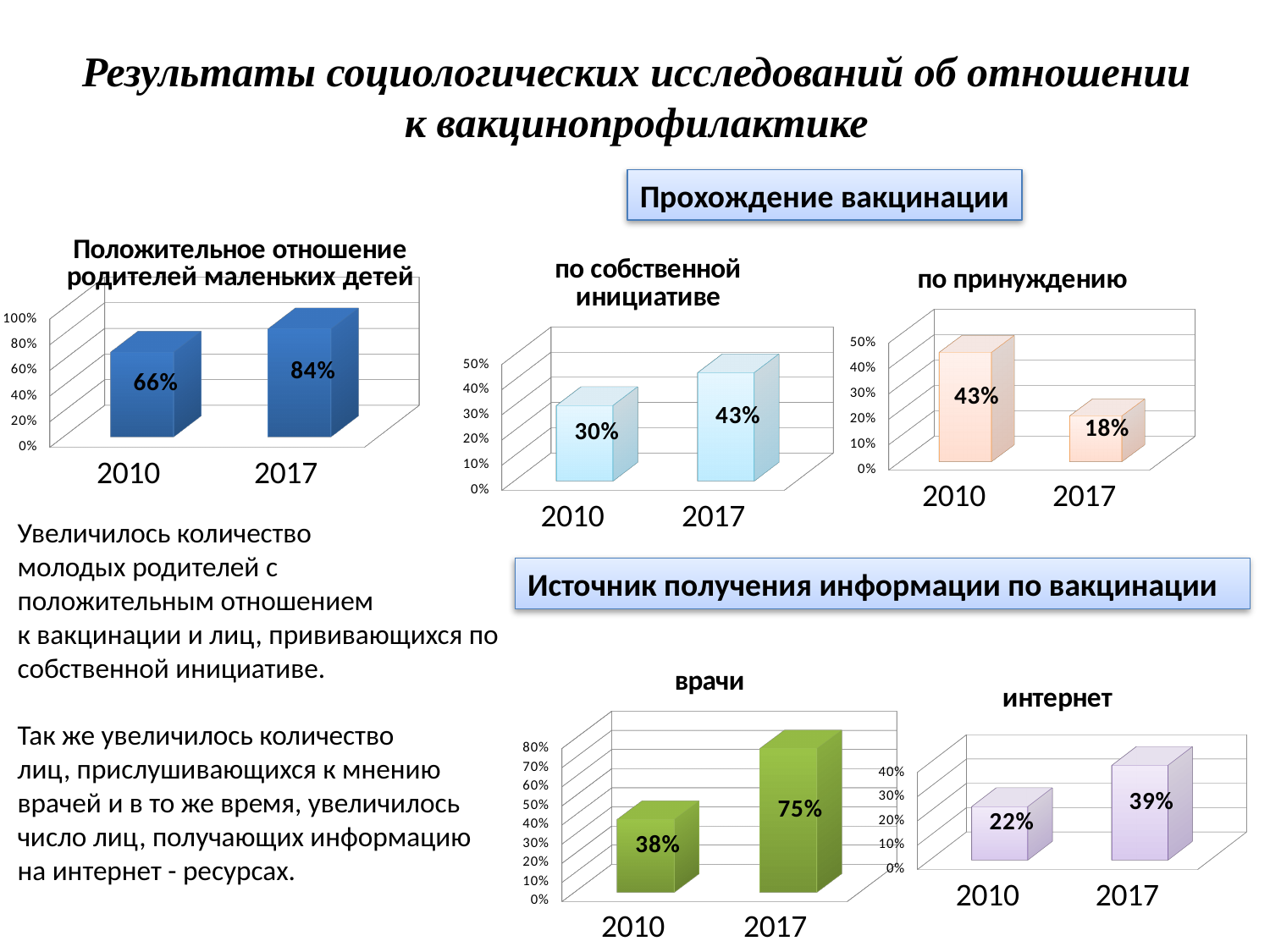
In the chart titled "по собственной инициативе", what is the value for 2010? 30% In the chart titled "по принуждению", do the values rise or fall from 2010 to 2017? fall In the chart titled "по принуждению", what is the difference between the 2010 and 2017 values? 25% In the chart titled "Положительное отношение родителей маленьких детей", what is the value for 2017? 84% In the chart titled "по собственной инициативе", which year has the higher value? 2017 In the chart titled "интернет", how many categories are shown on the x axis? 2 In the chart titled "по принуждению", what is the value for 2017? 18% What kind of chart is the one titled "врачи"? bar chart In the chart titled "врачи", which year has the lower value? 2010 In the chart titled "интернет", what is the value for 2010? 22% In the chart titled "Положительное отношение родителей маленьких детей", what is the difference between the 2017 and 2010 values? 18% In the chart titled "врачи", what is the value for 2017? 75%